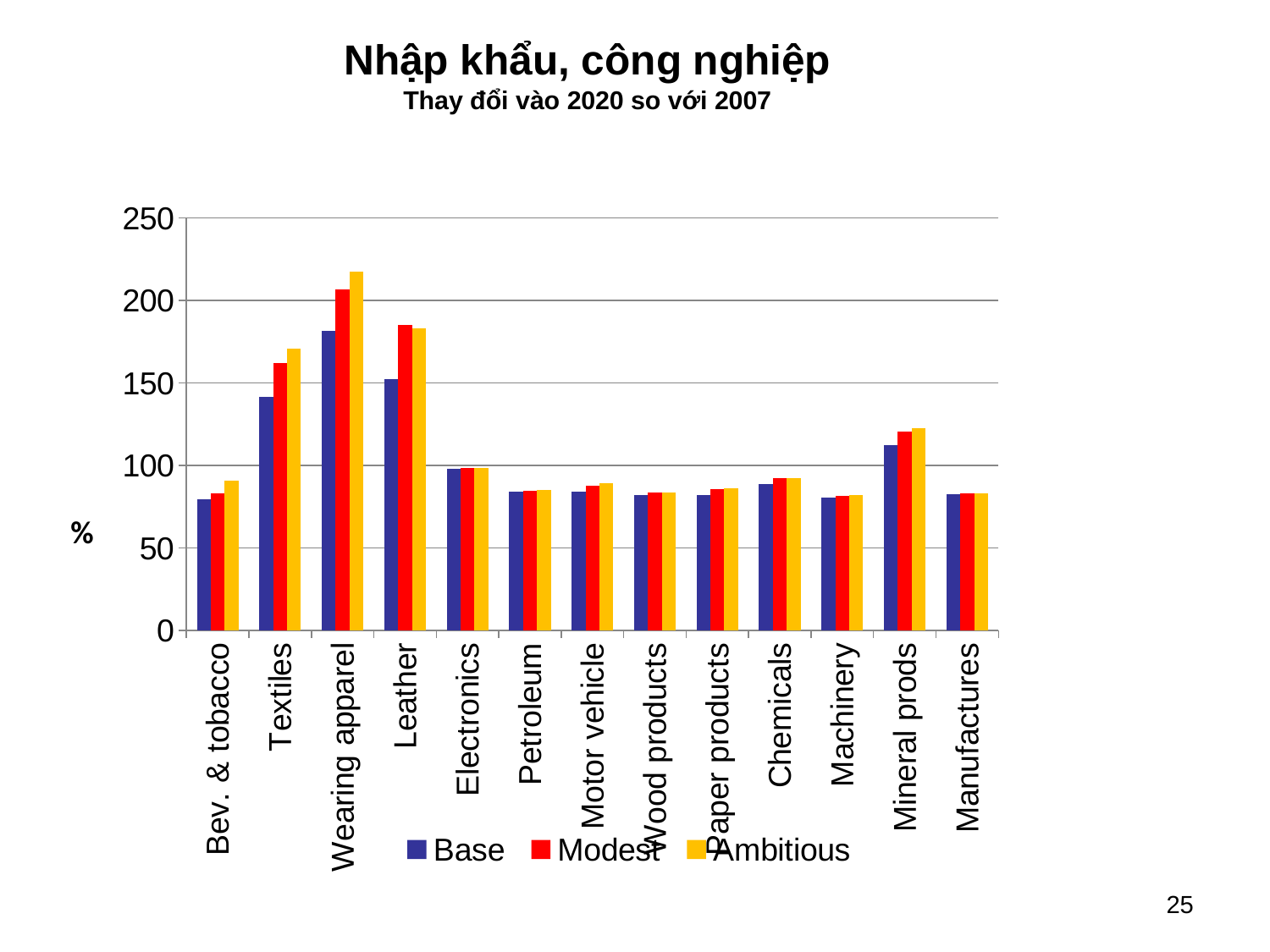
Which is larger, the Base value for Mineral prods or the Base value for Chemicals? Mineral prods Which category has the highest Ambitious value? Wearing apparel Which category has the highest Base value? Wearing apparel How many series does the legend list? 3 What is the title of the chart? Nhập khẩu, công nghiệp How many categories are shown on the x axis? 13 Is the Ambitious value for Wearing apparel greater or less than 200? greater Is the Base value for Mineral prods greater or less than 100? greater What kind of chart is shown on the slide? bar chart Is the Base value for Petroleum greater or less than 100? less Which is larger, the Ambitious value for Textiles or the Ambitious value for Leather? Leather